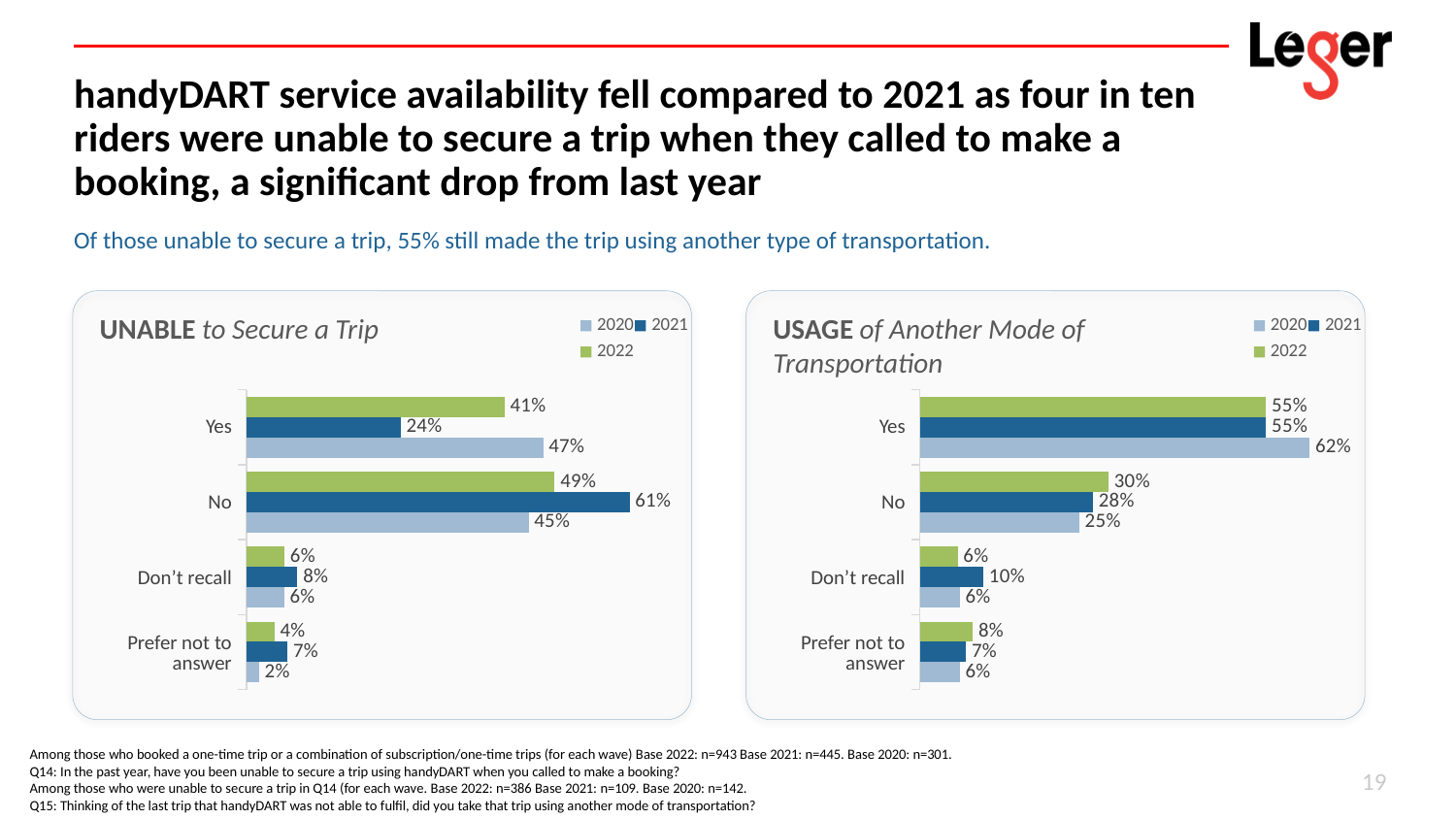
How many series does the legend of the 'UNABLE to Secure a Trip' chart list? 3 In the 'USAGE of Another Mode of Transportation' chart, what is the difference between the 2022 and 2020 values for 'No'? 5 percentage points What type of chart is the 'USAGE of Another Mode of Transportation' chart? Bar chart In the 'UNABLE to Secure a Trip' chart, which category has the highest 2021 value? No In the 'USAGE of Another Mode of Transportation' chart, what is the 2021 value for 'Don't recall'? 10% In the 'USAGE of Another Mode of Transportation' chart, what is the 2020 value for 'Yes'? 62% In the 'UNABLE to Secure a Trip' chart, what is the 2022 value for 'Yes'? 41% In the 'UNABLE to Secure a Trip' chart, what is the difference between the 2020 and 2021 values for 'Yes'? 23 percentage points In the 'UNABLE to Secure a Trip' chart, what is the 2020 value for 'Prefer not to answer'? 2% In the 'UNABLE to Secure a Trip' chart, what is the 2021 value for 'No'? 61% In the 'USAGE of Another Mode of Transportation' chart, is the 2022 value for 'No' larger or smaller than the 2020 value for 'No'? larger